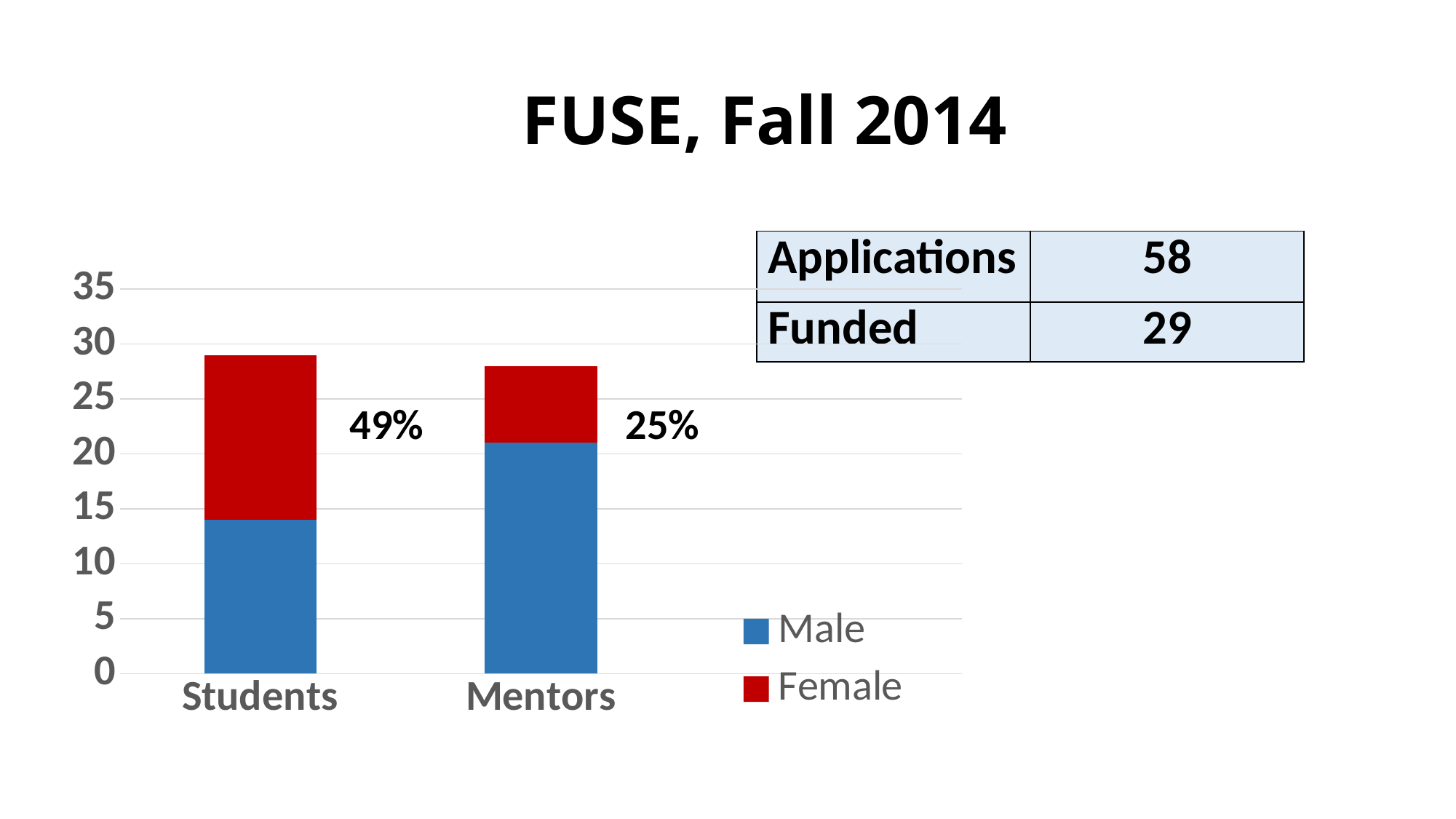
What percentage label is printed next to the Mentors bar? 25% How many series does the chart's legend list? 2 Is the total height of the Students bar greater or less than 25? greater Which category has the larger Female segment, Students or Mentors? Students Is the Male value for Students greater or less than 15? less What are the two series named in the chart's legend? Male and Female What percentage label is printed next to the Students bar? 49% Is the Male value for Mentors greater or less than 20? greater Which category has the larger Male segment, Students or Mentors? Mentors What is the title shown above the chart? FUSE, Fall 2014 How many categories are shown on the x axis of the chart? 2 What kind of chart is shown on the slide? Stacked bar chart